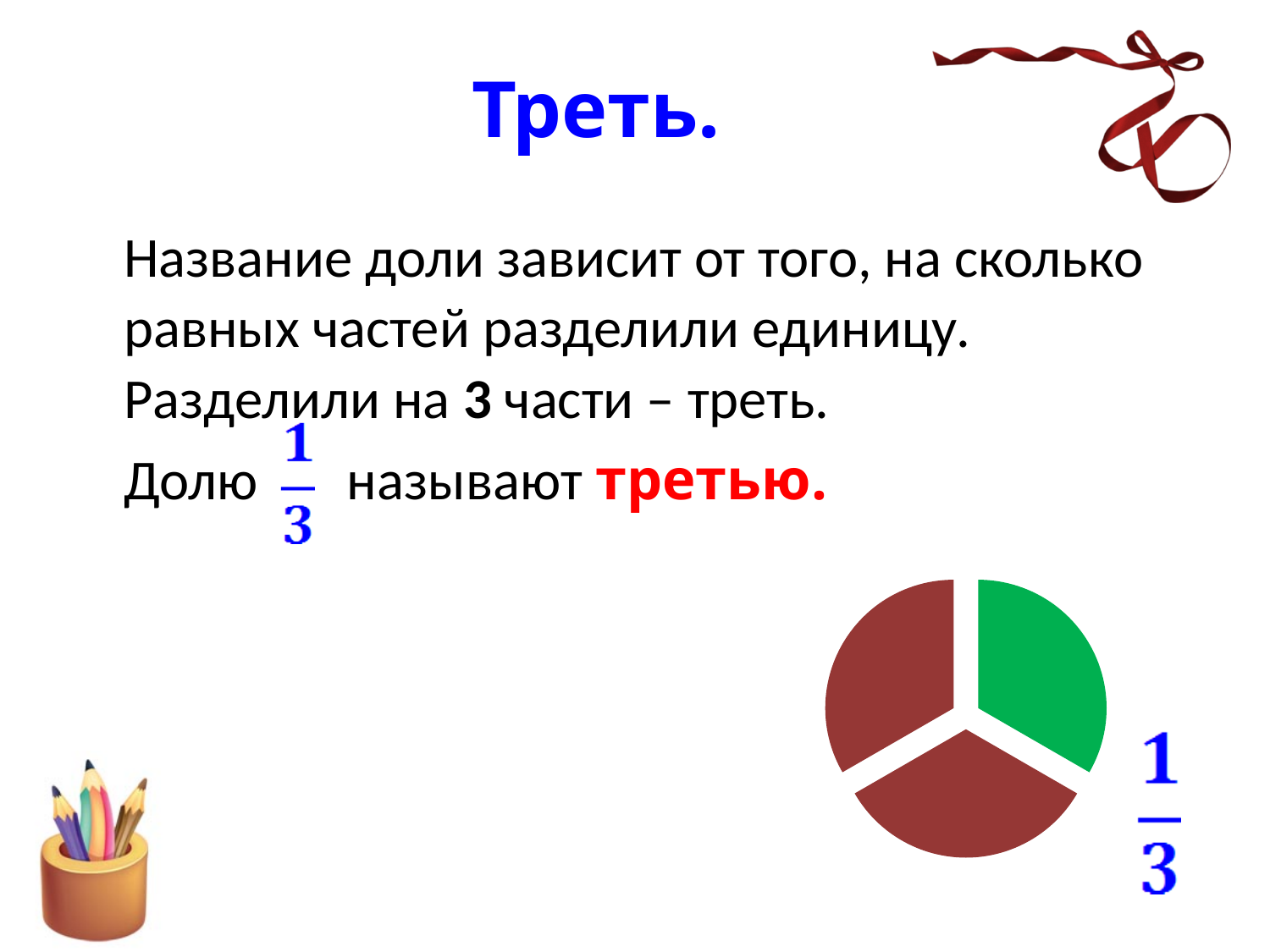
How many slices of the pie chart are coloured green? 1 How many slices is the pie chart divided into? 3 Are the slices of the pie chart equal in size? yes What fraction of the pie does the green slice represent, according to the label next to the chart? 1/3 What kind of chart is shown on the slide? pie chart What colour are the two slices of the pie chart that are not green? dark red